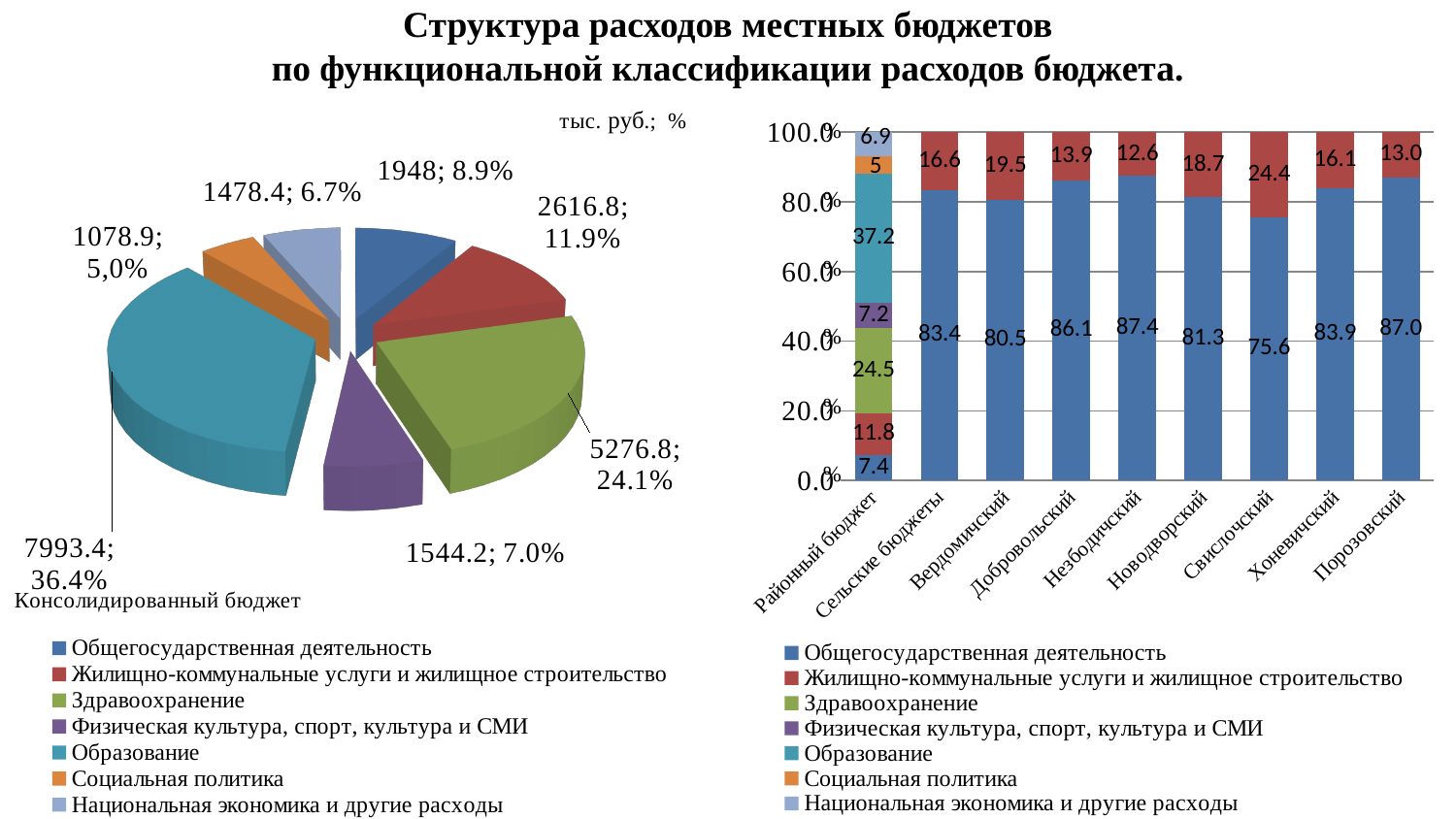
In the stacked bar chart on the right, what is the value of the Образование segment for Районный бюджет? 37.2 In the pie chart on the left, what value in тыс. руб. is shown for the Здравоохранение slice? 5276.8 In the stacked bar chart on the right, which is larger: the Общегосударственная деятельность value for Порозовский or for Вердомичский? Порозовский What type of chart is shown on the right side of the slide? Stacked bar chart In the stacked bar chart on the right, what is the value of the Общегосударственная деятельность segment for Незбодичский? 87.4 How many series does the legend of the stacked bar chart on the right list? 7 In the pie chart on the left, which category has the smallest share? Социальная политика In the pie chart on the left, what share does Образование (the largest slice) have? 36.4% In the stacked bar chart on the right, which category has the largest Жилищно-коммунальные услуги segment among the rural budgets? Свислочский In the stacked bar chart on the right, how many categories are shown on the x axis? 9 In the pie chart on the left, what is the difference in тыс. руб. between Образование (7993.4) and Здравоохранение (5276.8)? 2716.6 In the pie chart on the left, how many slices are there? 7